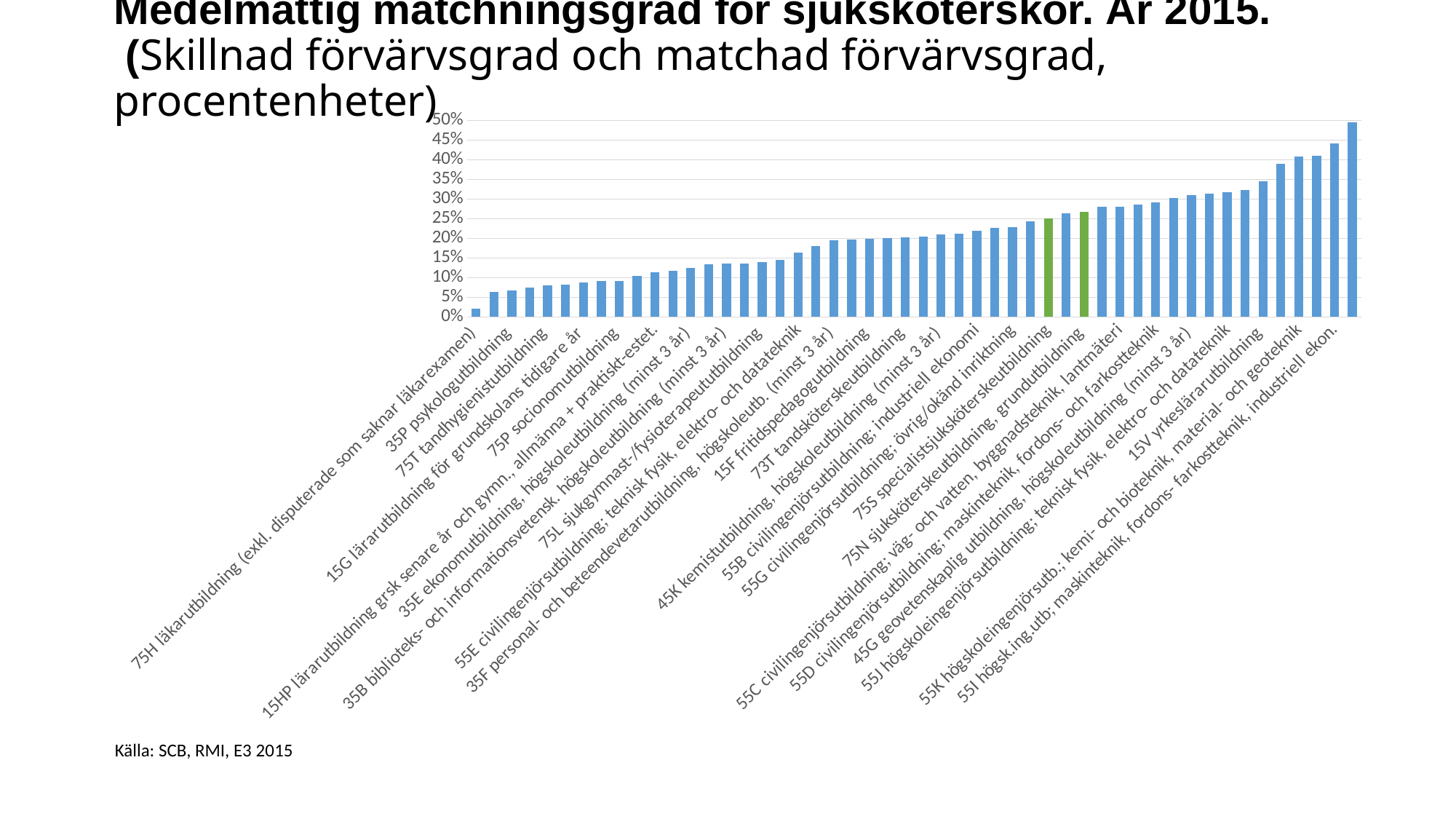
Which has the larger value: 75N sjuksköterskeutbildning, grundutbildning or 75H läkarutbildning (exkl. disputerade som saknar läkarexamen)? 75N sjuksköterskeutbildning, grundutbildning Which category has the lowest value in the chart? 75H läkarutbildning (exkl. disputerade som saknar läkarexamen) Is the value for 15F fritidspedagogutbildning greater or less than 15%? greater Is the value for 75H läkarutbildning (exkl. disputerade som saknar läkarexamen) greater or less than 5%? less Is the value for 75S specialistsjuksköterskeutbildning greater or less than 30%? less Do the bar values rise or fall from left to right along the x axis? rise What is the highest value shown on the y axis of the chart? 50% How many bars in the chart are coloured green? 2 What kind of chart is shown on the slide? bar chart